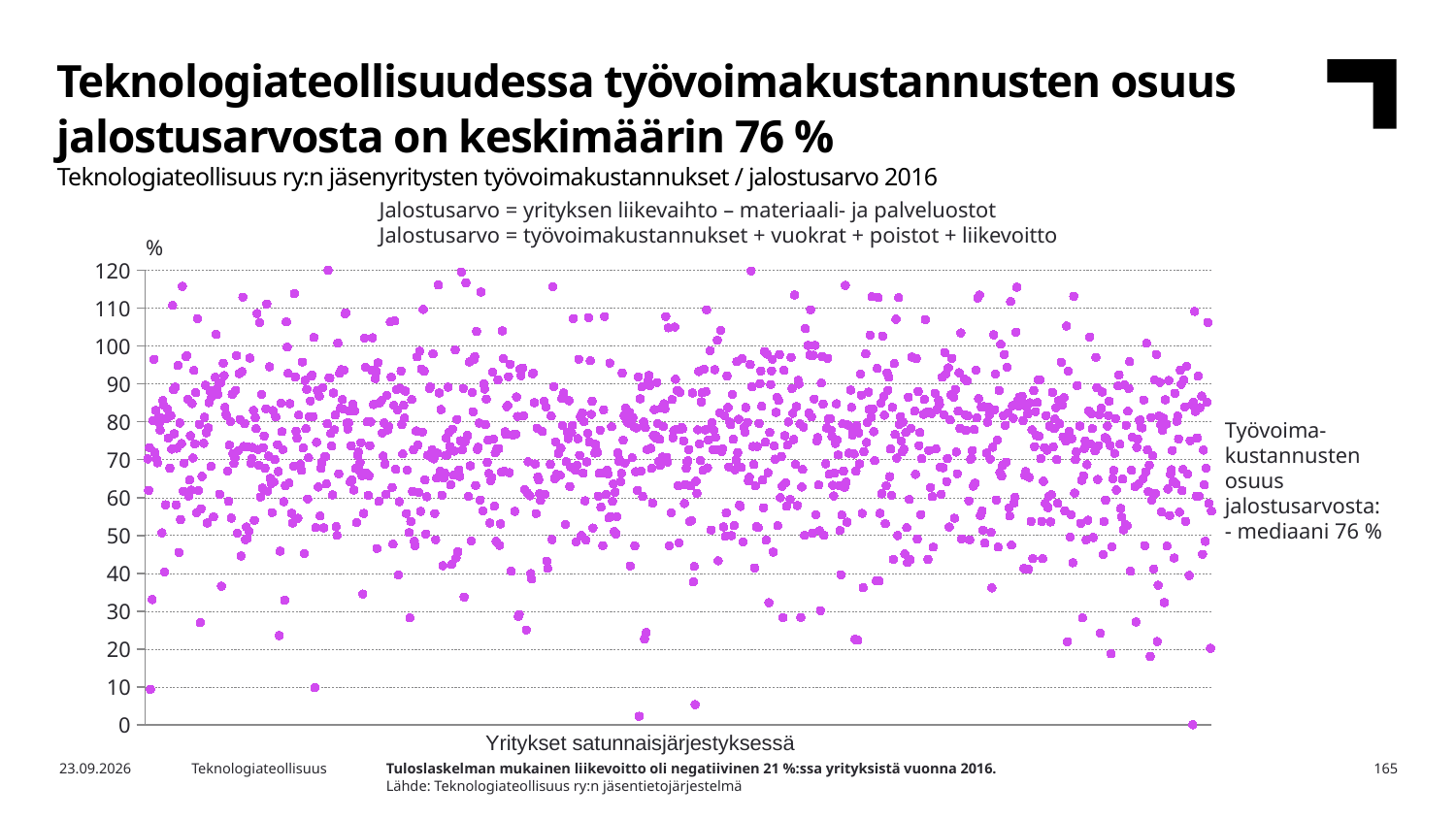
According to the annotation on the right of the chart, what is the median share of labour costs in value added (mediaani)? 76 % What unit is shown at the top of the y axis of the chart? % What kind of chart is shown on the slide? scatter chart What is the label of the x axis of the chart? Yritykset satunnaisjärjestyksessä